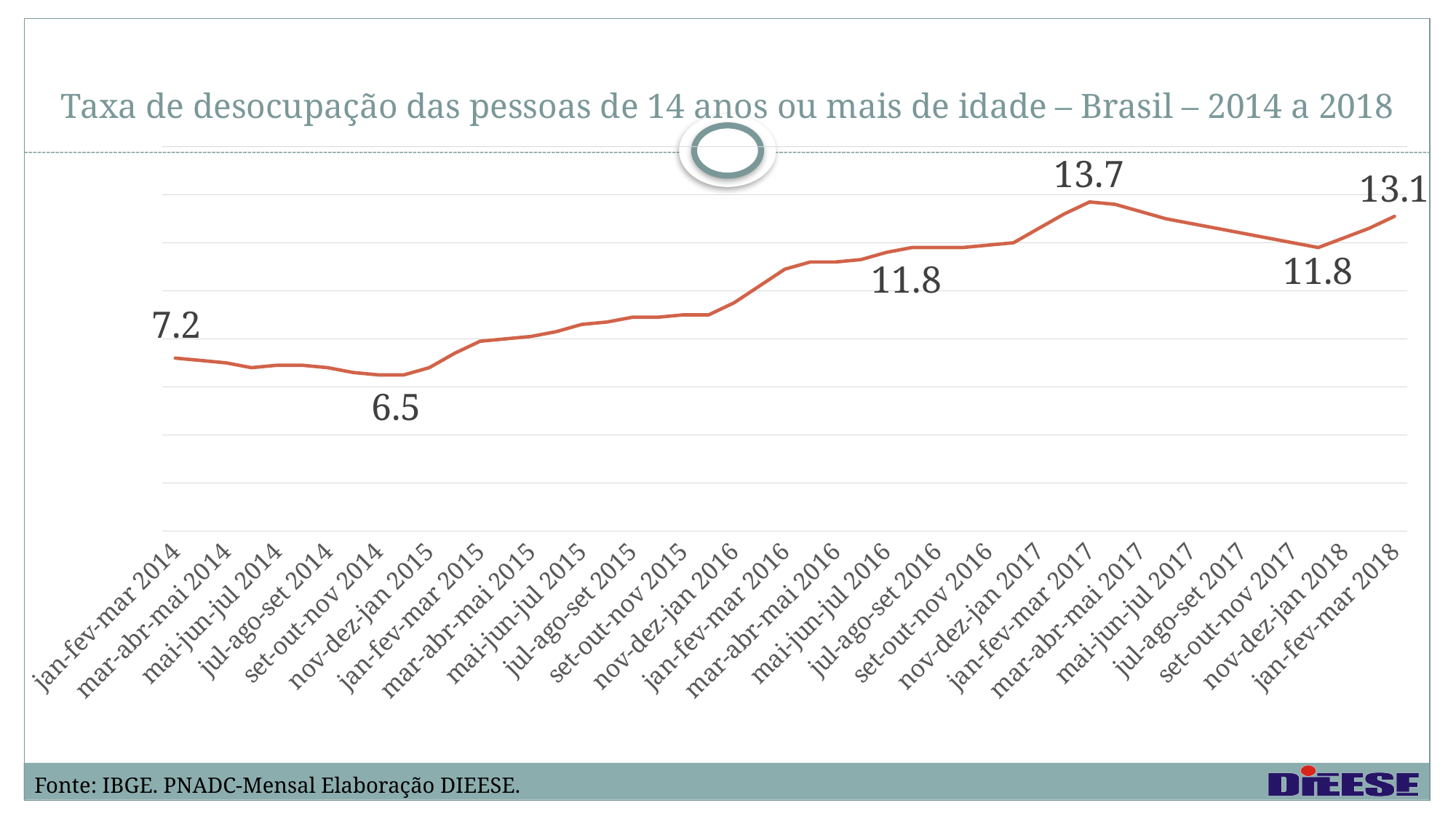
What is the title of the chart? Taxa de desocupação das pessoas de 14 anos ou mais de idade – Brasil – 2014 a 2018 What is the unemployment rate for jan-fev-mar 2014? 7.2 What is the unemployment rate for set-out-nov 2014? 6.5 Which period has the highest unemployment rate? jan-fev-mar 2017 What is the unemployment rate for jan-fev-mar 2018? 13.1 What is the unemployment rate for jan-fev-mar 2017? 13.7 Which is larger, the unemployment rate in jan-fev-mar 2018 or in jan-fev-mar 2014? jan-fev-mar 2018 What type of chart is shown on the slide? line chart What is the difference between the unemployment rate in jan-fev-mar 2017 and in set-out-nov 2014? 7.2 Which period has the lowest unemployment rate? set-out-nov 2014